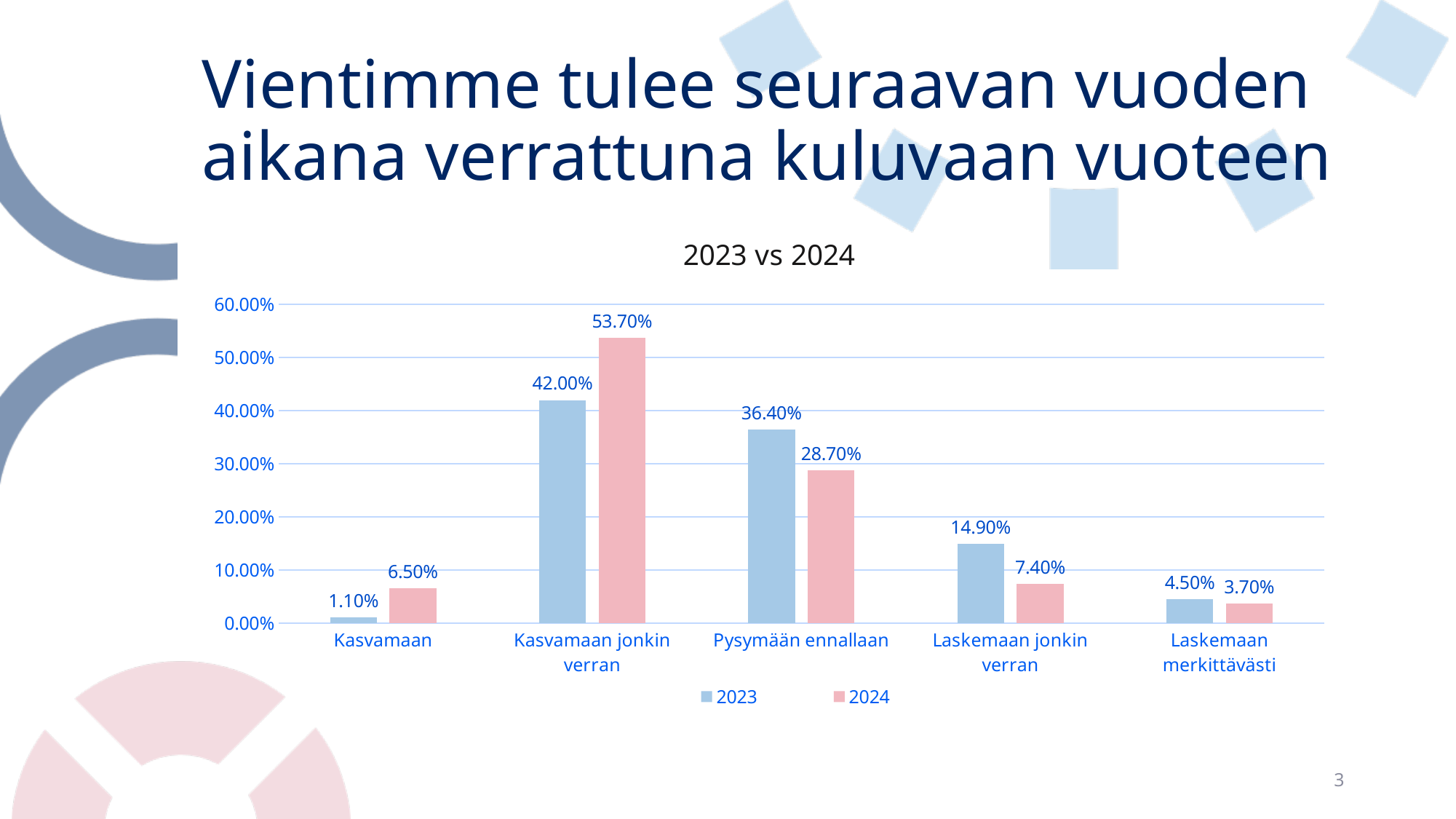
What type of chart is shown on the slide? Bar chart What is the 2023 value for "Pysymään ennallaan"? 36.40% What is the 2023 value for "Kasvamaan"? 1.10% What is the difference between the 2023 and 2024 values for "Laskemaan jonkin verran"? 7.50% Which category has the lowest 2023 value? Kasvamaan What is the 2024 value for "Kasvamaan jonkin verran"? 53.70% Which category has the highest 2024 value? Kasvamaan jonkin verran Is the 2023 value for "Kasvamaan jonkin verran" greater or less than 40.00%? greater How many series does the legend list? 2 What is the difference between the 2024 and 2023 values for "Kasvamaan jonkin verran"? 11.70% How many categories are shown on the x axis? 5 For "Pysymään ennallaan", which year has the larger value, 2023 or 2024? 2023